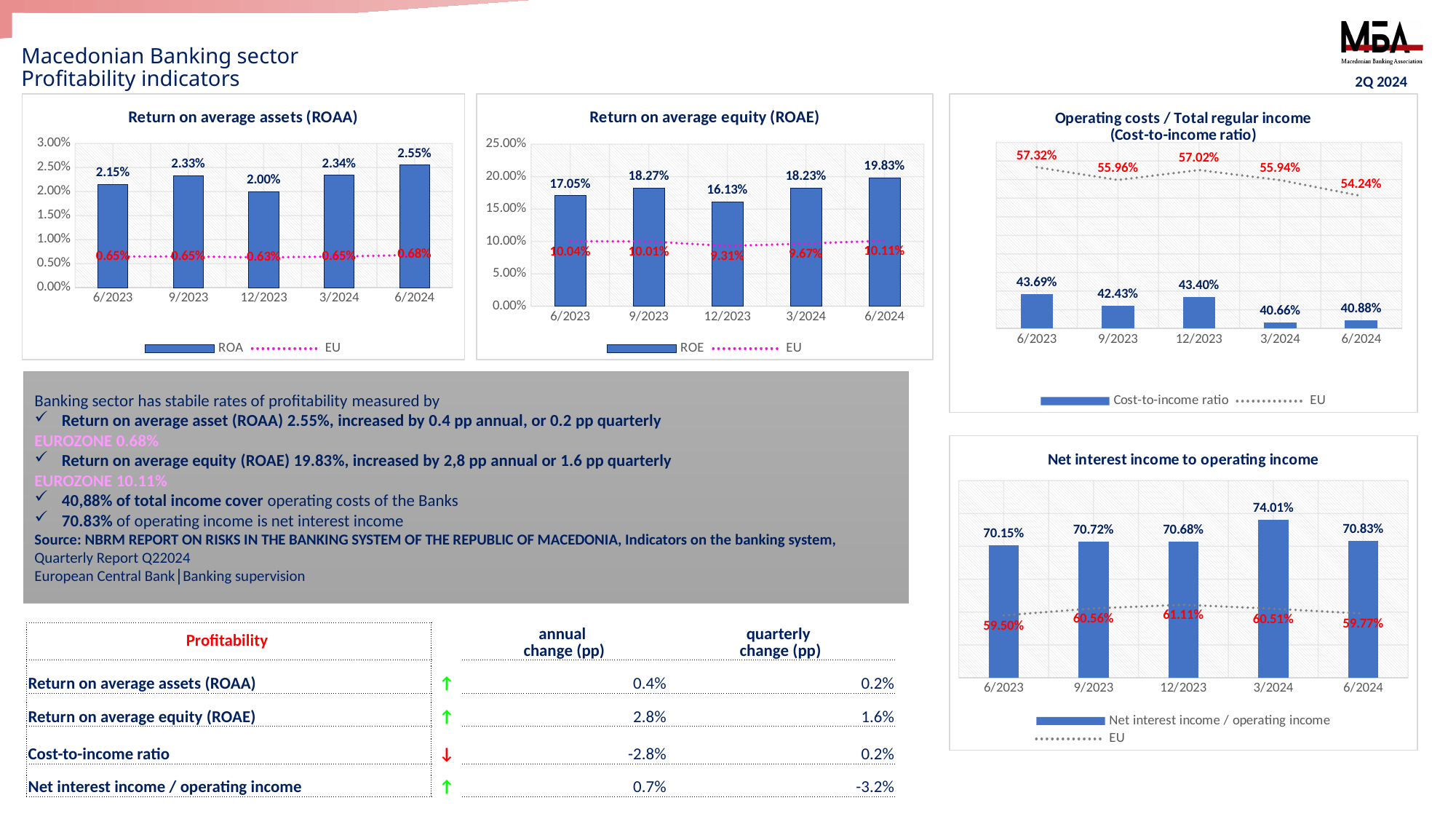
How many series does the legend of the 'Return on average assets (ROAA)' chart list? 2 In the 'Return on average assets (ROAA)' chart, what is the ROA value for 6/2024? 2.55% In the 'Return on average assets (ROAA)' chart, what is the EU value for 12/2023? 0.63% In the 'Return on average equity (ROAE)' chart, which period has the highest ROE value? 6/2024 In the 'Return on average assets (ROAA)' chart, which period has the lowest ROA value? 12/2023 How many periods are shown on the x axis of the 'Net interest income to operating income' chart? 5 In the 'Operating costs / Total regular income (Cost-to-income ratio)' chart, which period has the lowest Cost-to-income ratio? 3/2024 In the 'Return on average equity (ROAE)' chart, what is the difference between the ROE value and the EU value for 6/2024? 9.72 pp In the 'Net interest income to operating income' chart, what is the value for 3/2024? 74.01% In the 'Operating costs / Total regular income (Cost-to-income ratio)' chart, what is the EU value for 6/2023? 57.32% In the 'Return on average equity (ROAE)' chart, what is the ROE value for 9/2023? 18.27% In the 'Net interest income to operating income' chart, is the value for 6/2023 larger or the EU value for 6/2023? 6/2023 value (70.15%)